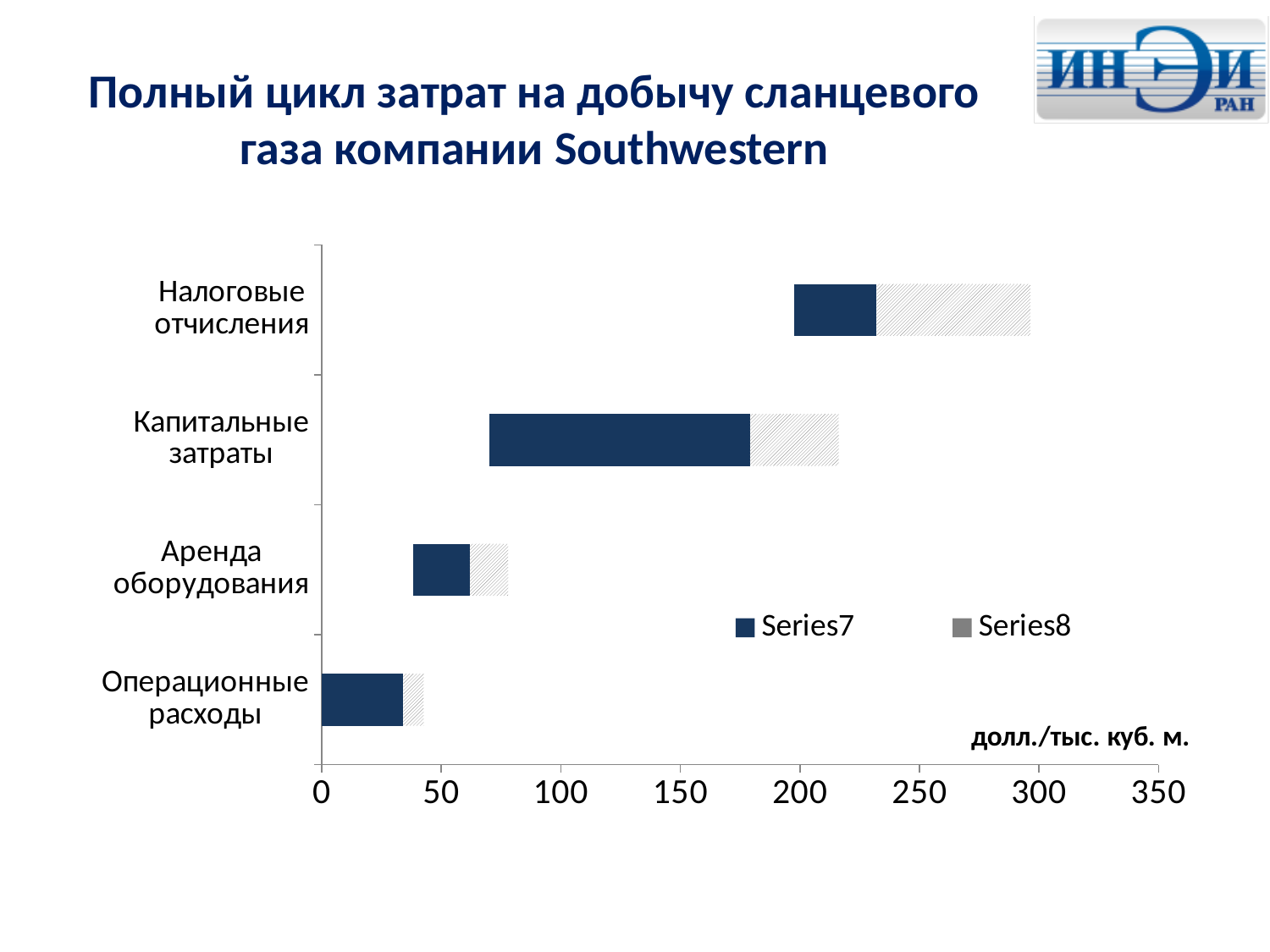
How many cost categories are shown on the vertical axis of the chart? 4 Is the right end of the bar for Операционные расходы greater or less than 50? less What unit is shown on the horizontal axis of the chart? долл./тыс. куб. м. How many series does the chart legend list? 2 Is the right end of the bar for Налоговые отчисления greater or less than 250? greater Is the right end of the bar for Капитальные затраты greater or less than 200? greater What kind of chart is shown on the slide? bar chart Which category's bar extends furthest to the right on the horizontal axis? Налоговые отчисления What are the names of the two series in the chart legend? Series7 and Series8